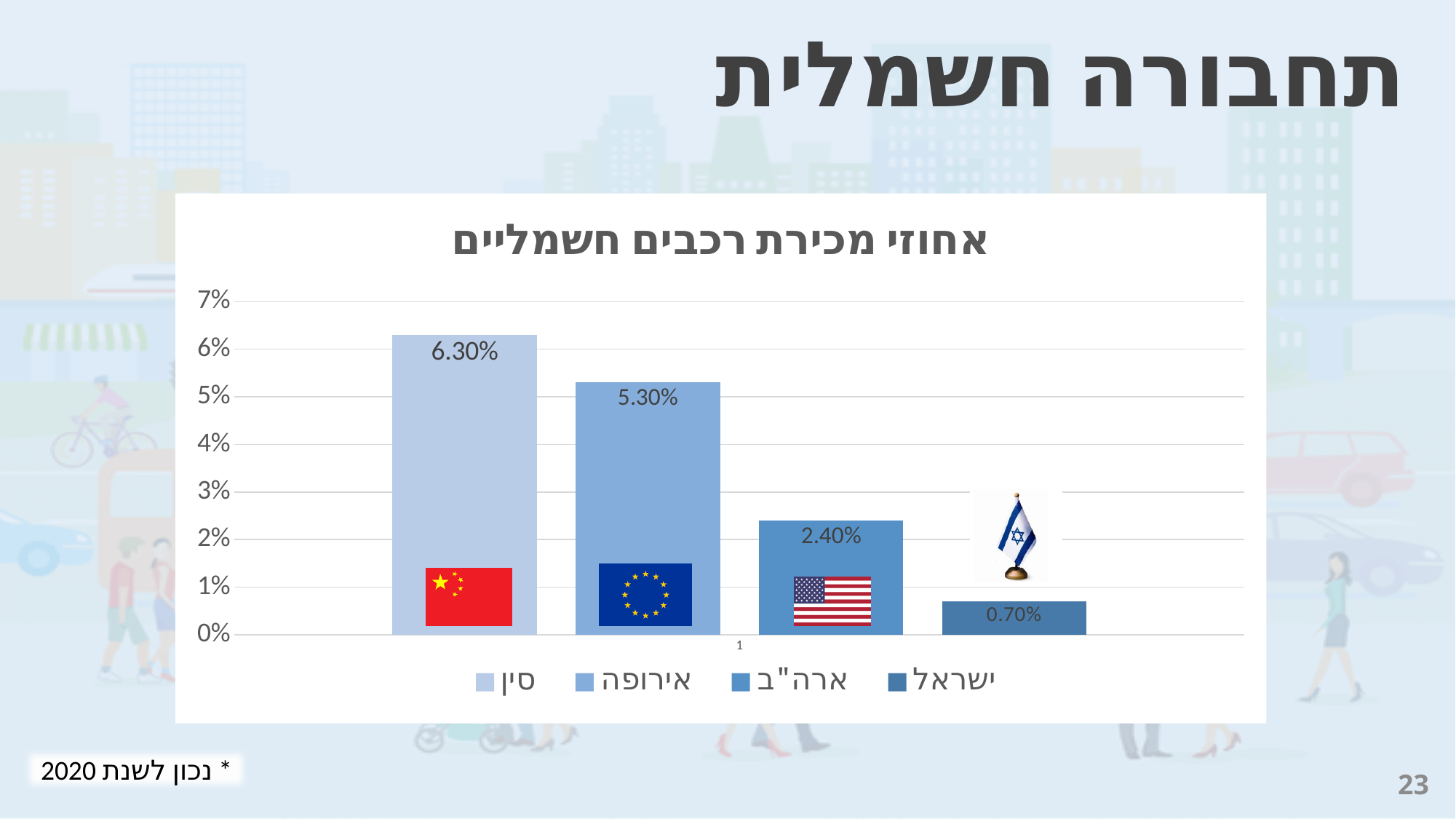
What is the value for ארה"ב (USA) in the chart? 2.40% How many categories are shown in the chart? 4 What is the title of the chart? אחוזי מכירת רכבים חשמליים Which is larger, the value for אירופה or the value for ארה"ב? אירופה What is the value for אירופה (Europe) in the chart? 5.30% Which category has the lowest value in the chart? ישראל What is the difference between the values for סין and אירופה? 1.00% Which category has the highest value in the chart? סין What is the difference between the values for ארה"ב and ישראל? 1.70% What is the value for סין (China) in the chart? 6.30% What is the value for ישראל (Israel) in the chart? 0.70% What kind of chart is shown on the slide? Bar chart